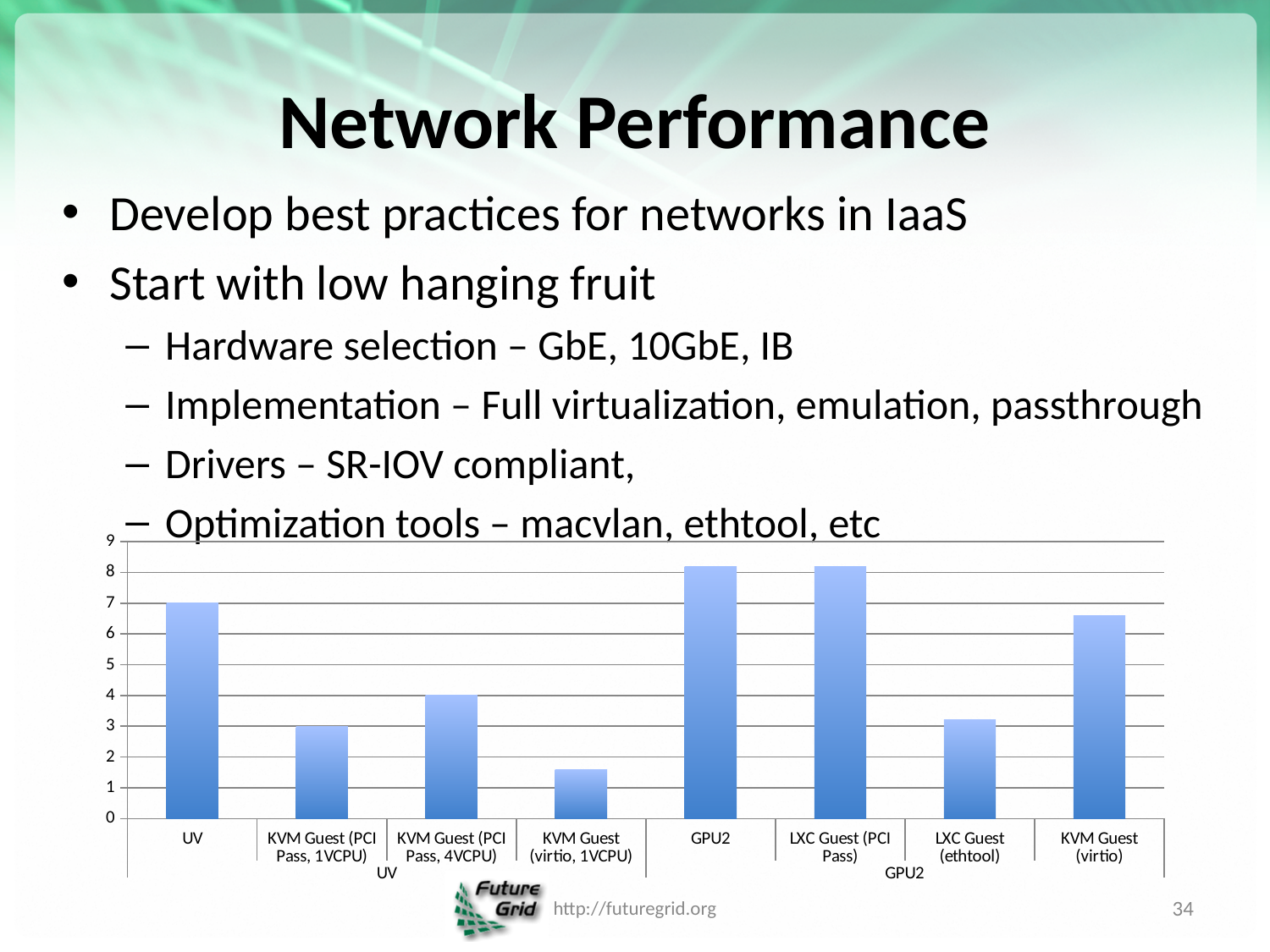
Is the value for GPU2 greater or less than 8? greater Which is larger, the value for KVM Guest (PCI Pass, 4VCPU) or the value for LXC Guest (ethtool)? KVM Guest (PCI Pass, 4VCPU) What are the two group labels shown beneath the category axis? UV and GPU2 What is the value for KVM Guest (PCI Pass, 4VCPU)? 4 Is the value for KVM Guest (virtio, 1VCPU) greater or less than 2? less What is the value for UV? 7 How many bars (categories) does the chart show? 8 What is the value for KVM Guest (PCI Pass, 1VCPU)? 3 Which is larger, the value for UV or the value for KVM Guest (virtio)? UV Which category has the lowest value? KVM Guest (virtio, 1VCPU) Is the value for KVM Guest (virtio) greater or less than 7? less What kind of chart is shown on the slide? bar chart